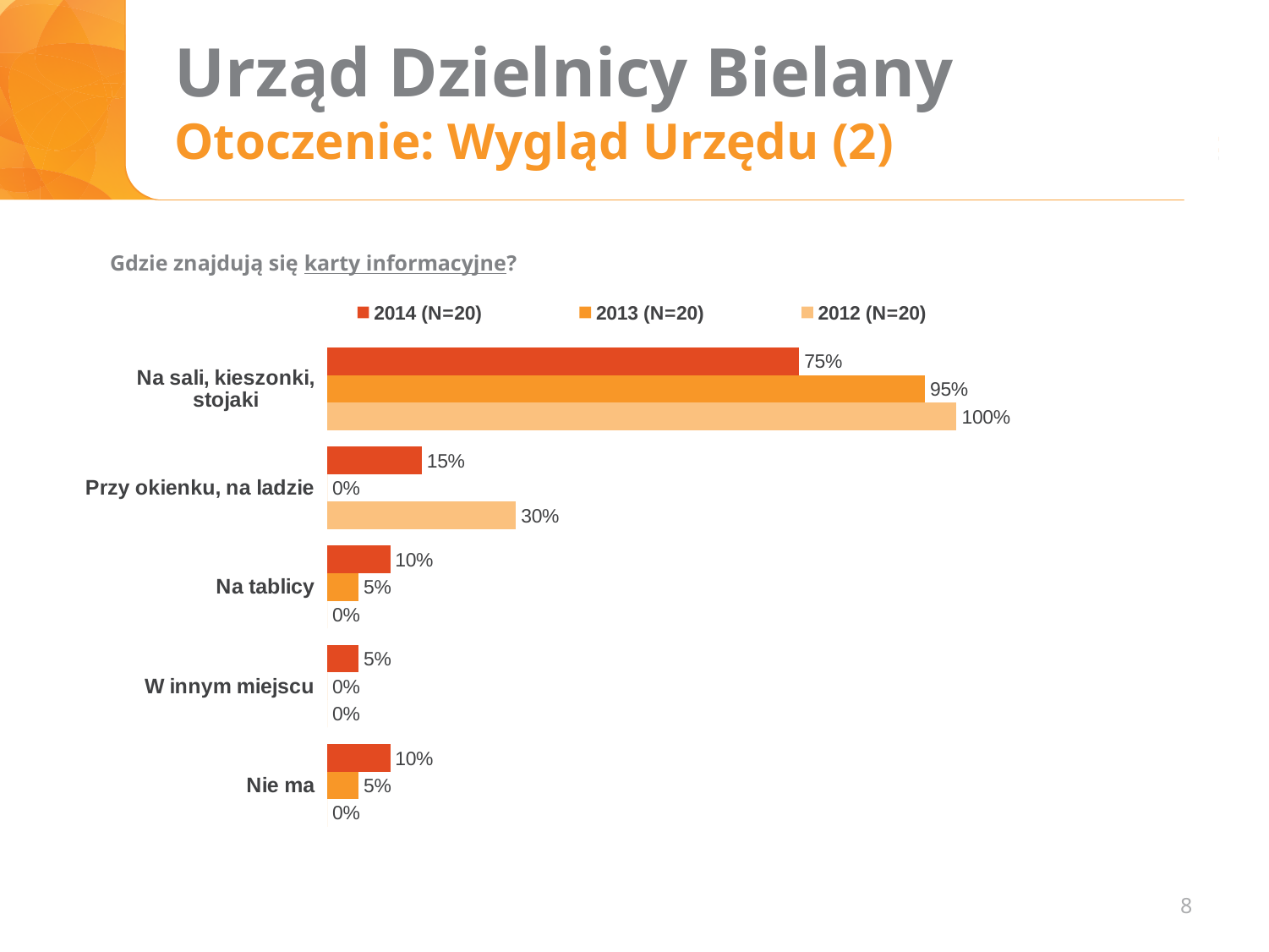
What is the value for 'W innym miejscu' in the 2014 (N=20) series? 5% Which category has the highest value in the 2012 (N=20) series? Na sali, kieszonki, stojaki What is the value for 'Przy okienku, na ladzie' in the 2012 (N=20) series? 30% How many series does the legend list? 3 What is the value for 'Na tablicy' in the 2013 (N=20) series? 5% How many categories are shown on the chart? 5 What is the difference between the 2012 (N=20) and 2014 (N=20) values for 'Przy okienku, na ladzie'? 15% What is the value for 'Na sali, kieszonki, stojaki' in the 2014 (N=20) series? 75% What kind of chart is shown on the slide? Bar chart Which category has the lowest value in the 2014 (N=20) series? W innym miejscu What is the difference between the 2012 (N=20) and 2014 (N=20) values for 'Na sali, kieszonki, stojaki'? 25% Which is larger for 'Nie ma': the 2014 (N=20) value or the 2013 (N=20) value? 2014 (N=20)